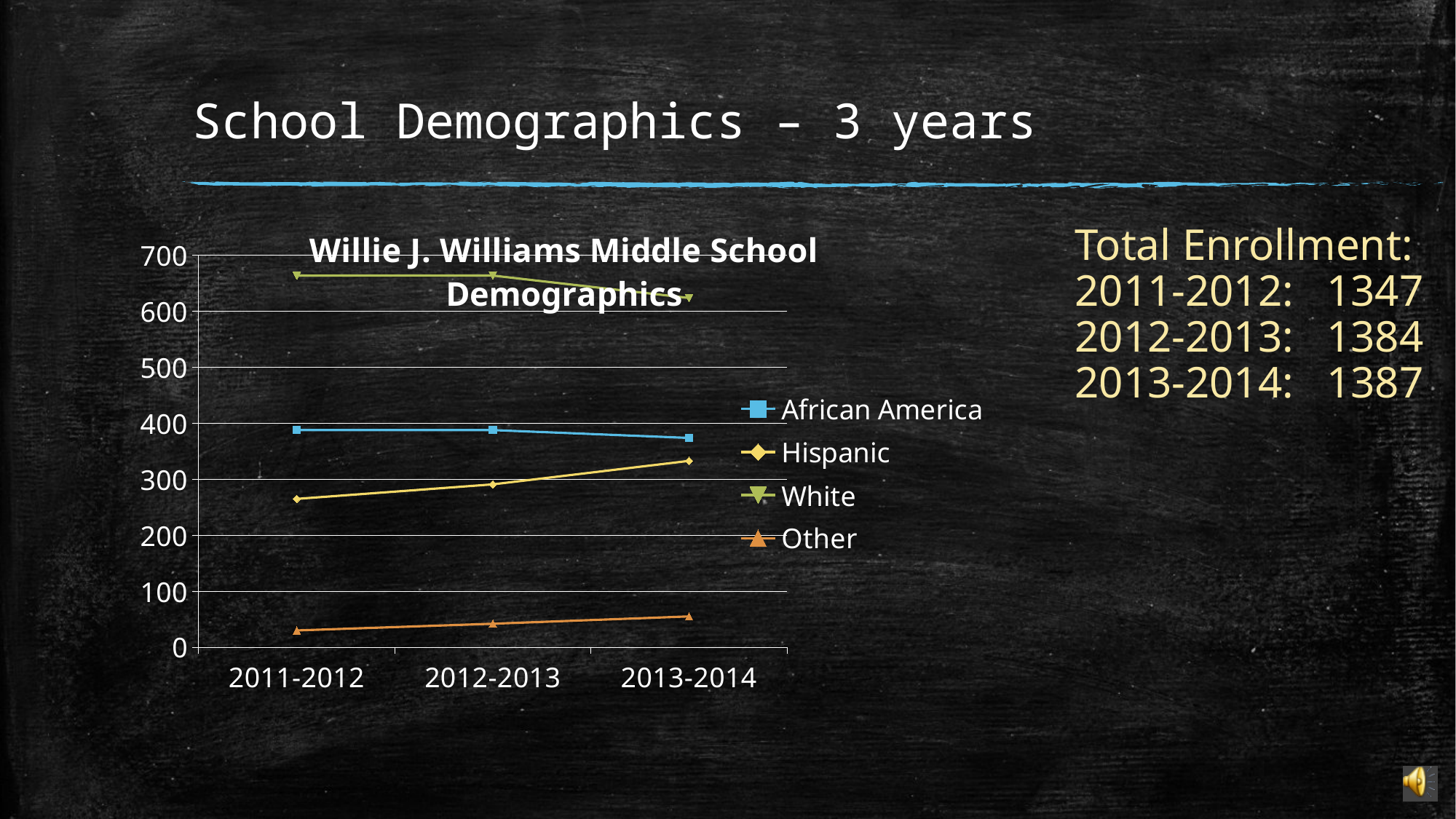
Does the White series rise or fall from 2012-2013 to 2013-2014? fall How many school years are plotted along the x axis? 3 Is the value for Hispanic in 2011-2012 greater or less than 300? less Does the Hispanic series rise or fall from 2011-2012 to 2013-2014? rise What kind of chart is shown on the slide? line chart In 2013-2014, which is larger: the value for African America or the value for Hispanic? African America What is the title of the chart? Willie J. Williams Middle School Demographics Is the value for Other in 2013-2014 greater or less than 100? less Is the value for White in 2011-2012 greater or less than 600? greater Which series has the highest value in 2013-2014? White How many series does the chart's legend list? 4 Which series has the lowest value in 2011-2012? Other